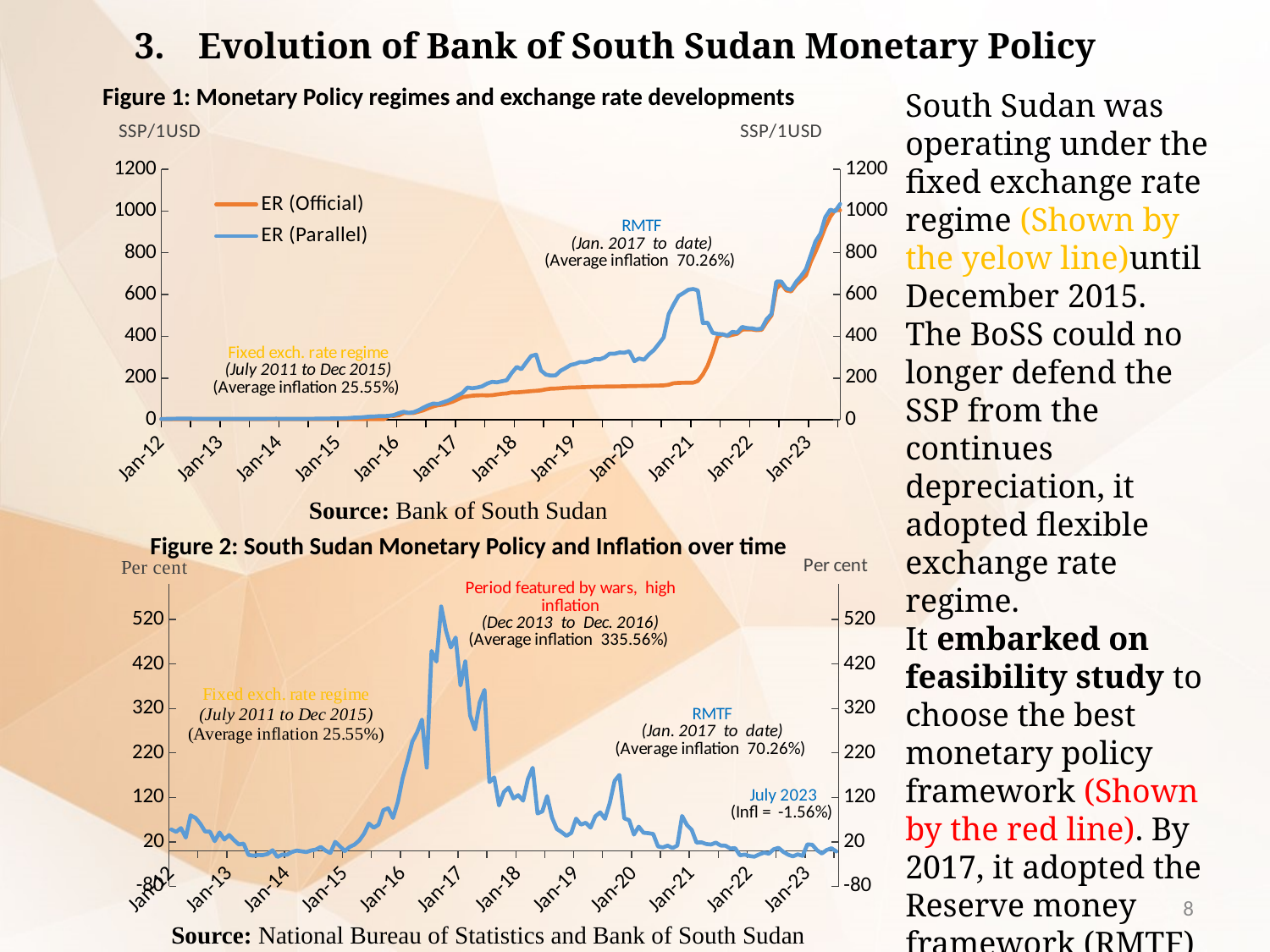
In Figure 1, what average inflation is annotated for the fixed exchange rate regime (July 2011 to Dec 2015)? 25.55% What kind of chart is Figure 1: Monetary Policy regimes and exchange rate developments? line chart In Figure 2, is the peak inflation value reached around Jan-17 greater or less than 420? greater In Figure 1, what average inflation is annotated for the RMTF period (Jan. 2017 to date)? 70.26% What are the two series named in the legend of Figure 1? ER (Official) and ER (Parallel) In Figure 2, what is the inflation value annotated for July 2023? -1.56% In Figure 1, is the ER (Parallel) value at Jan-20 greater or less than 200? greater In Figure 2, what average inflation is annotated for the period featured by wars and high inflation (Dec 2013 to Dec. 2016)? 335.56% In Figure 1, at Jan-19, which series is higher: ER (Official) or ER (Parallel)? ER (Parallel) In Figure 1, does the ER (Parallel) series overall rise or fall from Jan-12 to Jan-23? rise In Figure 1, is the ER (Official) value at Jan-20 greater or less than 200? less How many series does the legend of Figure 1 list? 2